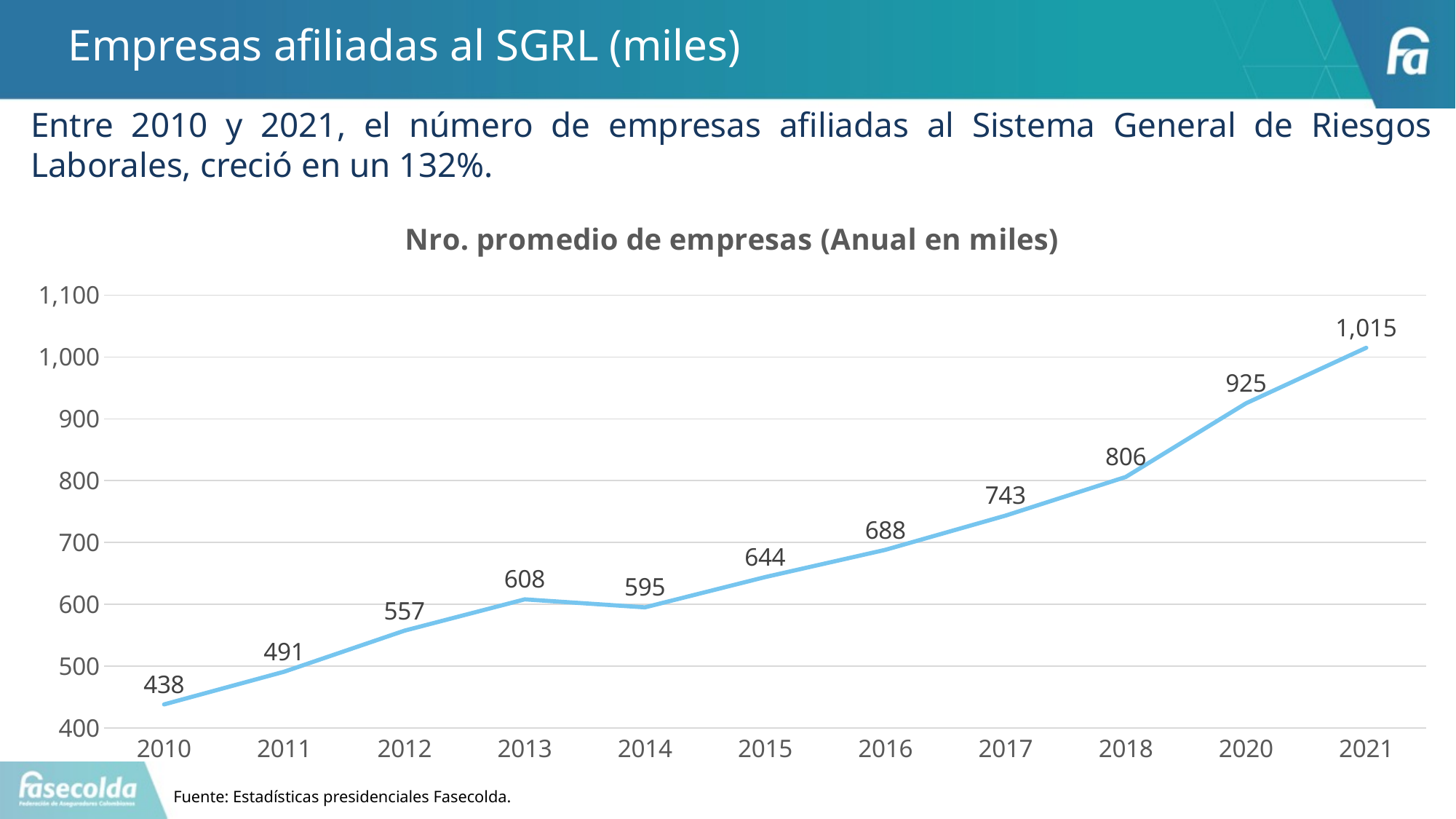
Which is larger, the value for 2013 or the value for 2014? 2013 What is the title of the chart? Nro. promedio de empresas (Anual en miles) Which year has the lowest value? 2010 What is the value for 2010? 438 What is the value for 2021? 1,015 What is the value for 2014? 595 What is the difference between the values for 2014 and 2013? 13 What is the difference between the values for 2021 and 2010? 577 Which year has the highest value? 2021 What kind of chart is shown? line chart Is the value for 2018 greater or less than 800? greater How many years are plotted on the x axis? 11